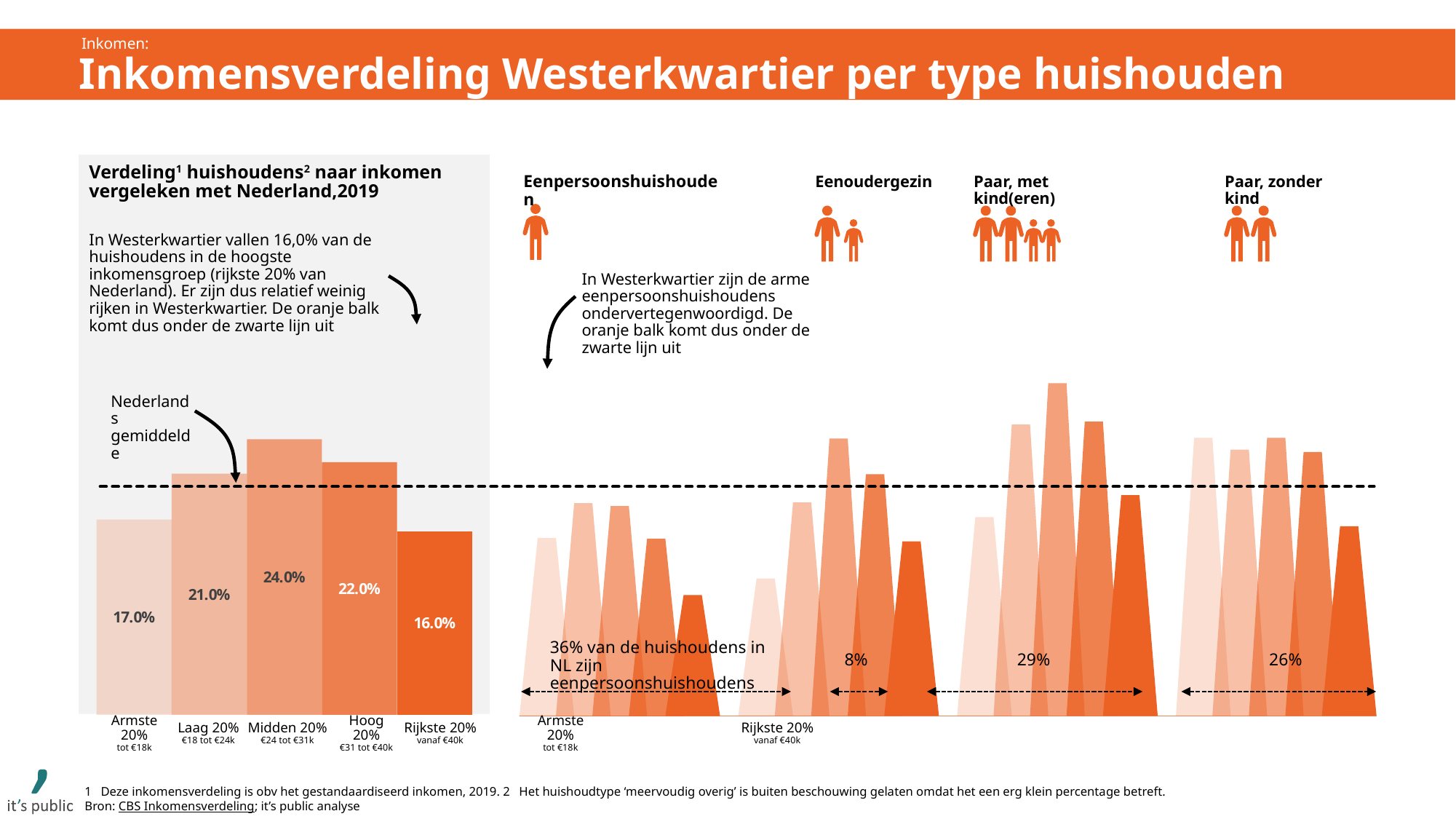
In the right chart, what percentage of households in NL are eenpersoonshuishoudens? 36% In the left chart, what is the value for Rijkste 20%? 16.0% In the left chart, what does the dashed horizontal line represent? Nederlands gemiddelde In the left chart, what is the difference between the values for Midden 20% and Rijkste 20%? 8.0% How many income groups are shown in the left chart? 5 In the left chart, what do the five bar values add up to? 100.0% In the left chart, which is larger: the value for Laag 20% or for Hoog 20%? Hoog 20% What kind of chart is the left chart? bar chart In the left chart, what percentage of households in Westerkwartier fall in the Midden 20% income group? 24.0% In the left chart, which income group has the lowest share of households? Rijkste 20% In the left chart, which income group has the highest share of households? Midden 20% How many household types are shown in the right chart? 4